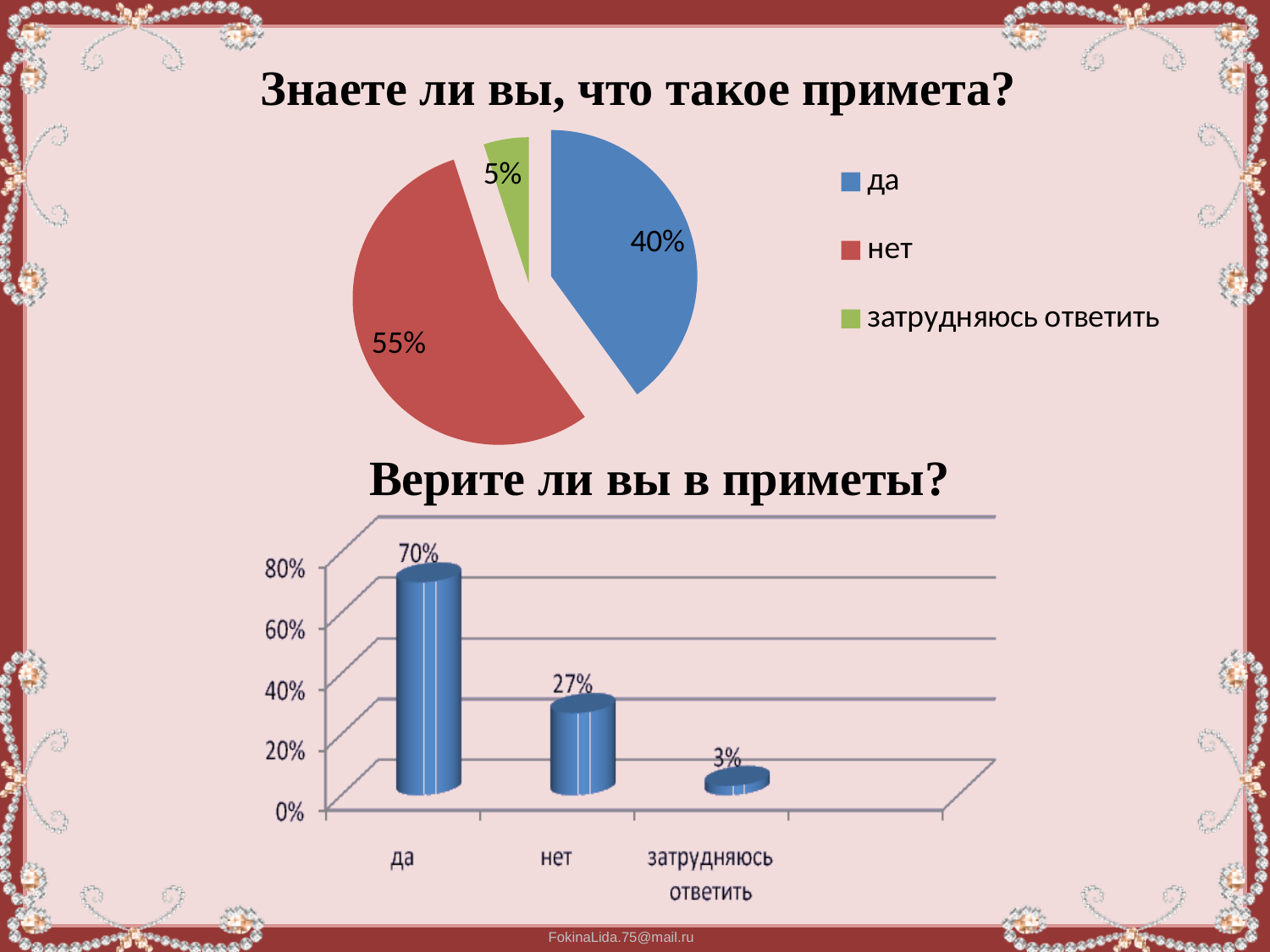
In the pie chart "Знаете ли вы, что такое примета?", how many entries does the legend list? 3 In the bar chart "Верите ли вы в приметы?", what is the value for "да"? 70% In the pie chart "Знаете ли вы, что такое примета?", which answer has the smallest slice? затрудняюсь ответить In the bar chart "Верите ли вы в приметы?", what is the difference between the values for "да" and "нет"? 43% In the bar chart "Верите ли вы в приметы?", which category has the highest value? да In the bar chart "Верите ли вы в приметы?", what is the value for "затрудняюсь ответить"? 3% In the pie chart "Знаете ли вы, что такое примета?", what colour is the slice for "затрудняюсь ответить"? green What type of chart is the lower chart titled "Верите ли вы в приметы?"? bar chart In the pie chart "Знаете ли вы, что такое примета?", what share of respondents answered "да"? 40% In the bar chart "Верите ли вы в приметы?", how many categories are shown on the x axis? 3 In the pie chart "Знаете ли вы, что такое примета?", which answer has the largest slice? нет In the pie chart "Знаете ли вы, что такое примета?", what share of respondents answered "нет"? 55%